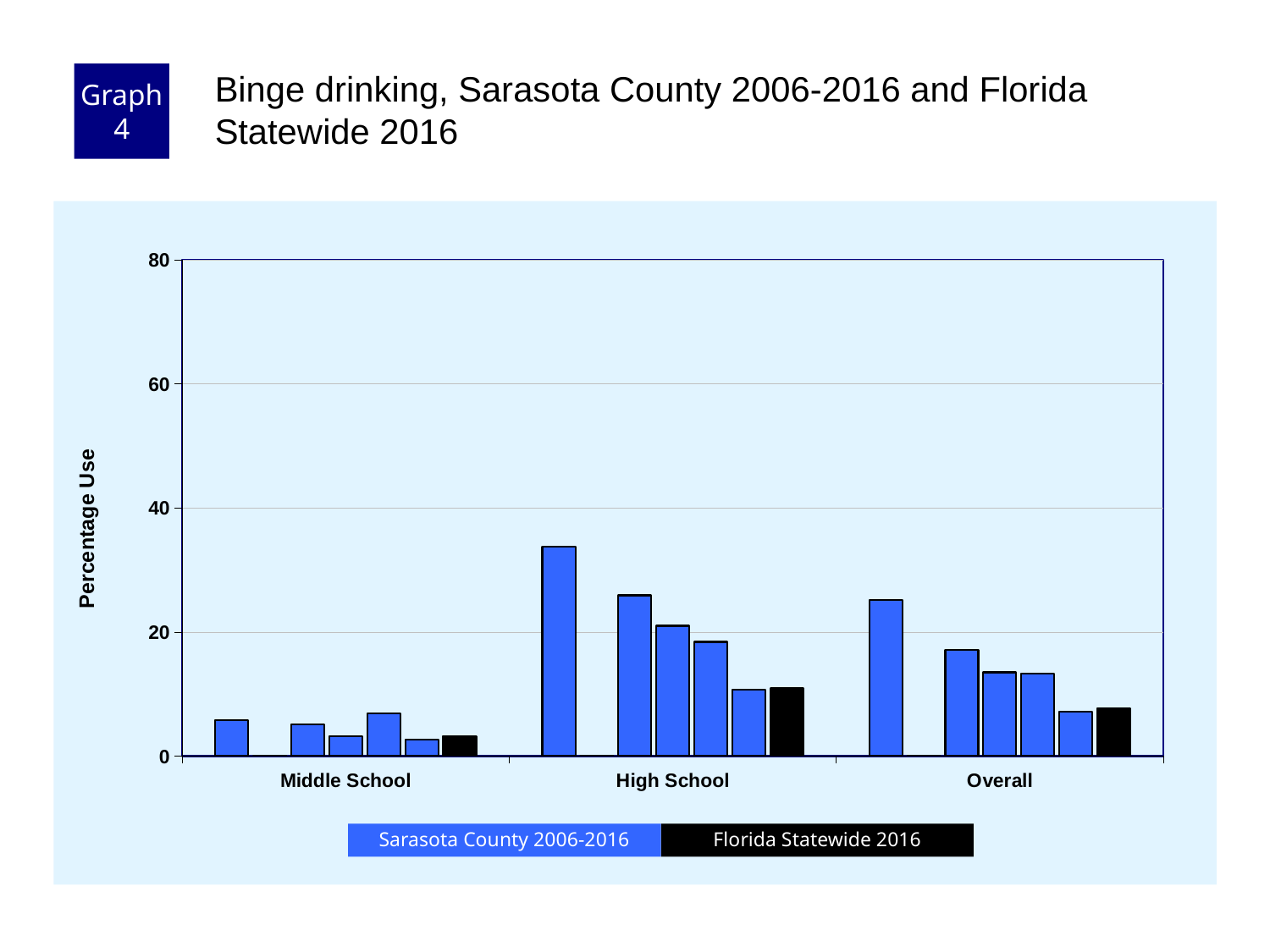
Is the tallest Sarasota County bar for High School greater or less than 20? greater What kind of chart is shown on the slide? bar chart Is the Florida Statewide 2016 value for High School greater or less than 20? less How many series does the legend list? 2 What is the label on the y axis? Percentage Use Which category contains the tallest bar? High School Is the tallest Sarasota County bar for Middle School greater or less than 20? less Within the High School category, do the Sarasota County 2006-2016 bars rise or fall from left to right? fall Which category contains the lowest bars overall? Middle School How many categories are shown on the x axis? 3 What is the title of the chart? Binge drinking, Sarasota County 2006-2016 and Florida Statewide 2016 Which is larger, the Florida Statewide 2016 value for High School or for Middle School? High School